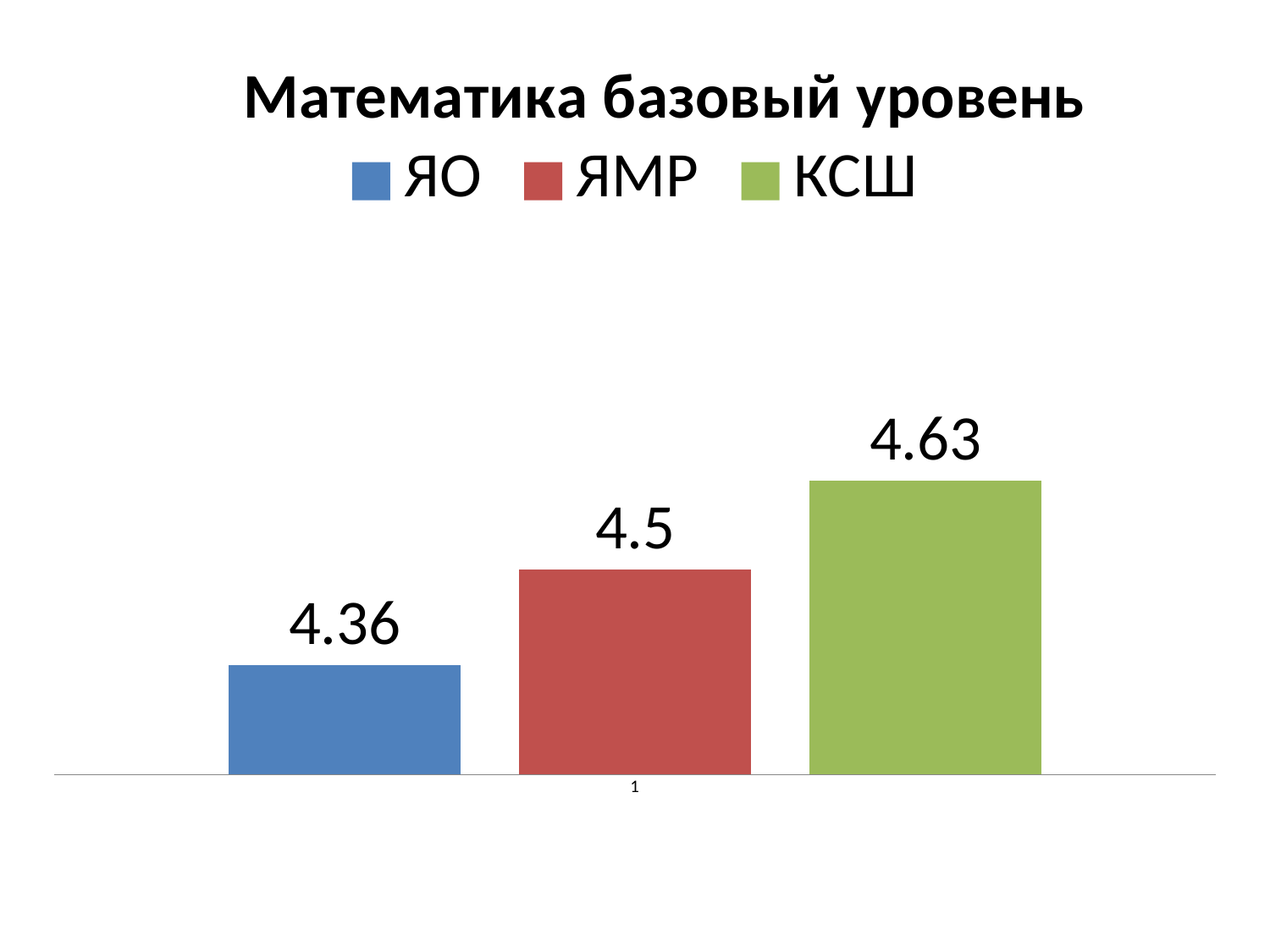
What is the value for КСШ? 4.63 Which is larger, the value for ЯМР or the value for КСШ? КСШ Which series has the highest value? КСШ How many series does the legend list? 3 What is the difference between the values for КСШ and ЯО? 0.27 What colour is the bar for ЯМР? red What is the value for ЯО? 4.36 What is the title of the chart? Математика базовый уровень What kind of chart is shown on the slide? bar chart What is the difference between the values for ЯМР and ЯО? 0.14 Which series has the lowest value? ЯО What is the value for ЯМР? 4.5